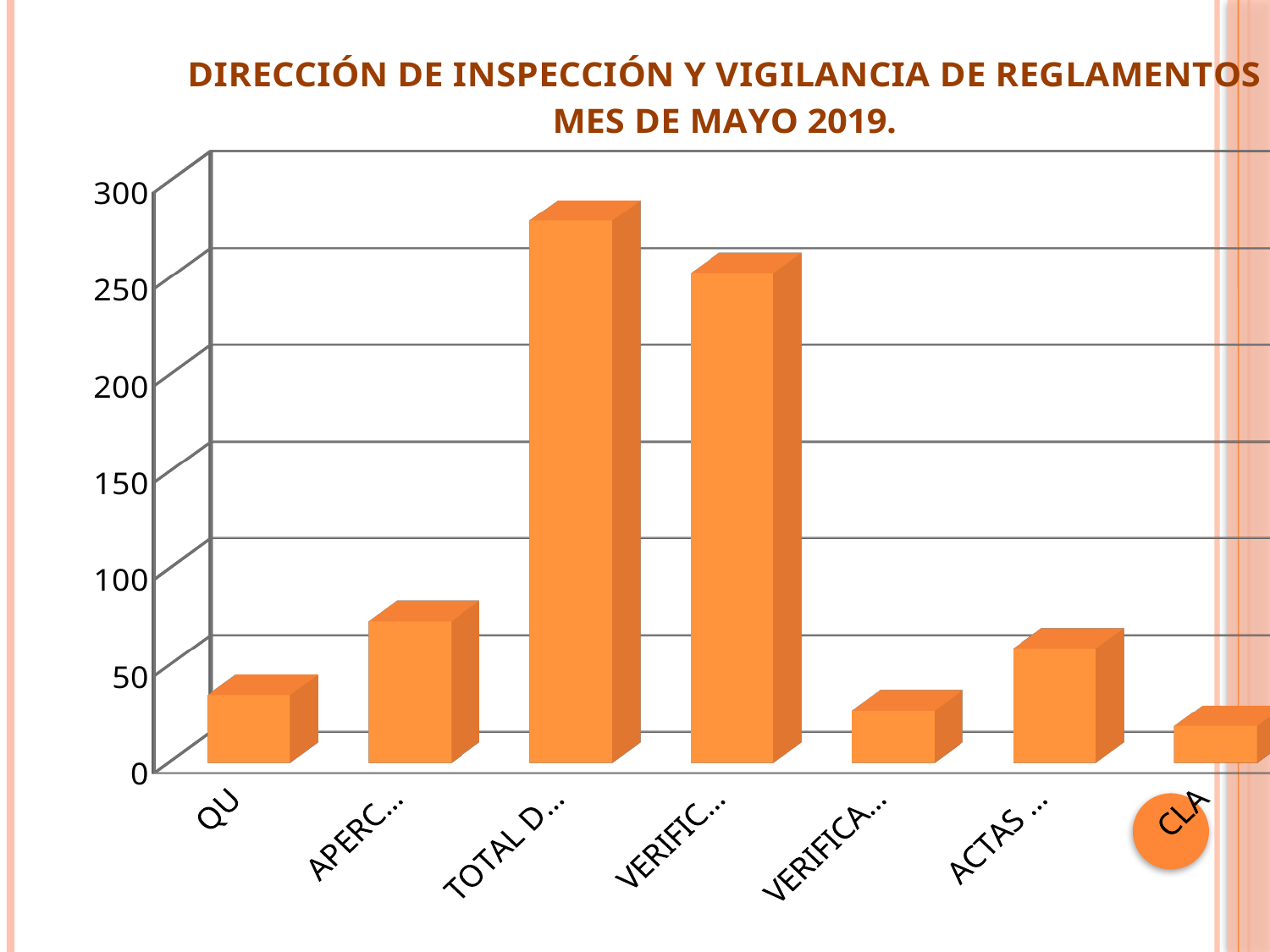
How many bars does the chart show? 7 Is the value of the last bar on the right (CLA) greater or less than 50? less Is the value of the second bar from the left (APERC…) greater or less than 50? greater Is the value of the third bar from the left (TOTAL D…) greater or less than 250? greater Which bar is the highest in the chart? the third bar from the left (TOTAL D…) What colour are the bars in the chart? orange What is the title of the chart? DIRECCIÓN DE INSPECCIÓN Y VIGILANCIA DE REGLAMENTOS MES DE MAYO 2019. Which is larger, the first bar from the left (QU) or the second bar from the left (APERC…)? the second bar (APERC…) What kind of chart is shown on the slide? bar chart Which is larger, the third bar from the left (TOTAL D…) or the fourth bar from the left (VERIFIC…)? the third bar (TOTAL D…)